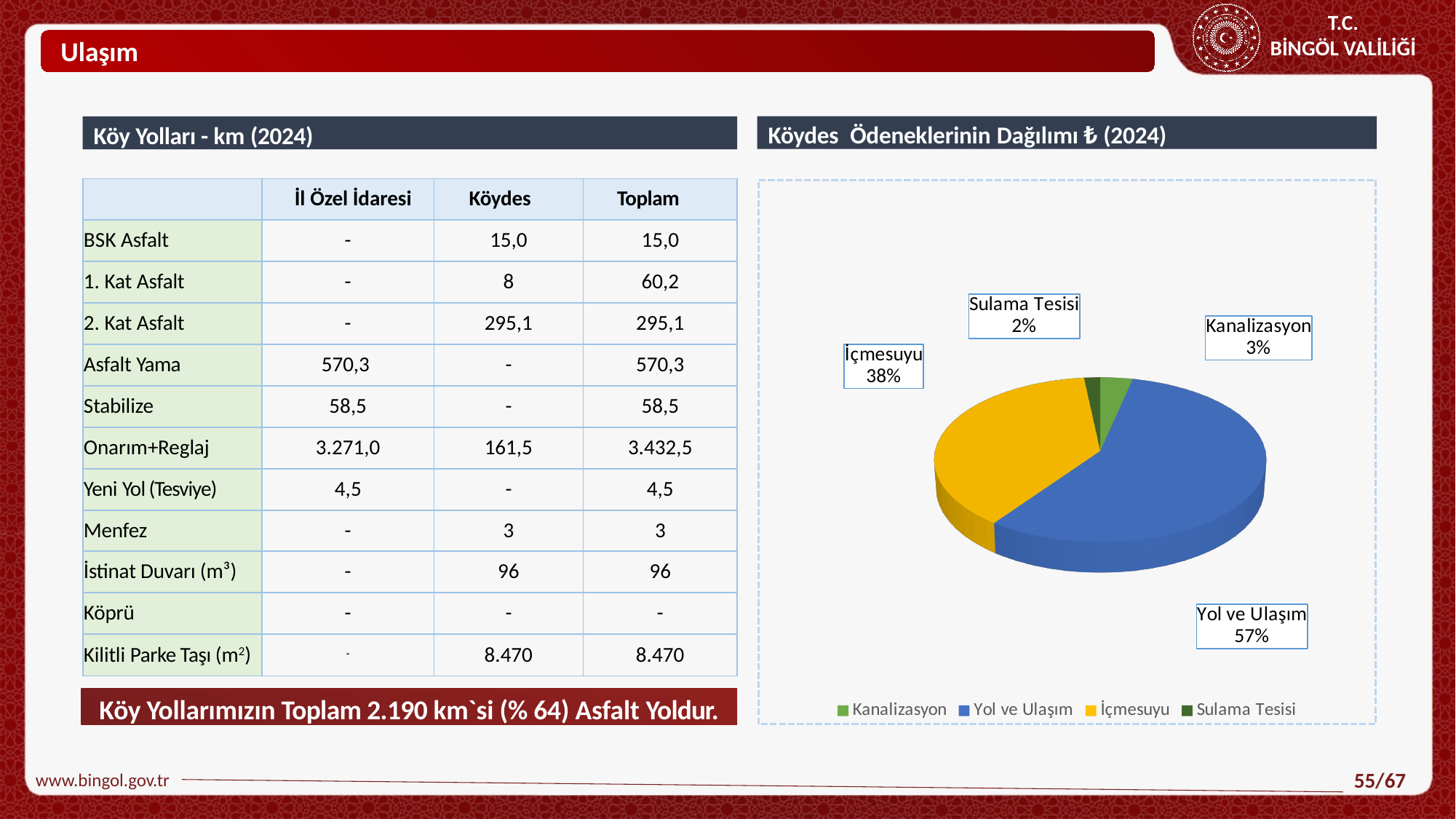
Which slice of the pie chart is the largest? Yol ve Ulaşım In the pie chart, what share does Kanalizasyon have? 3% In the pie chart, what share does Sulama Tesisi have? 2% Which slice of the pie chart is the smallest? Sulama Tesisi Which is larger in the pie chart, İçmesuyu or Kanalizasyon? İçmesuyu How many slices does the pie chart have? 4 In the pie chart, what share does Yol ve Ulaşım have? 57% What colour is the Yol ve Ulaşım slice in the pie chart? Blue What kind of chart is shown under the title "Köydes Ödeneklerinin Dağılımı ₺ (2024)"? Pie chart How many entries does the pie chart's legend list? 4 What is the difference in percentage points between the Yol ve Ulaşım and İçmesuyu slices? 19